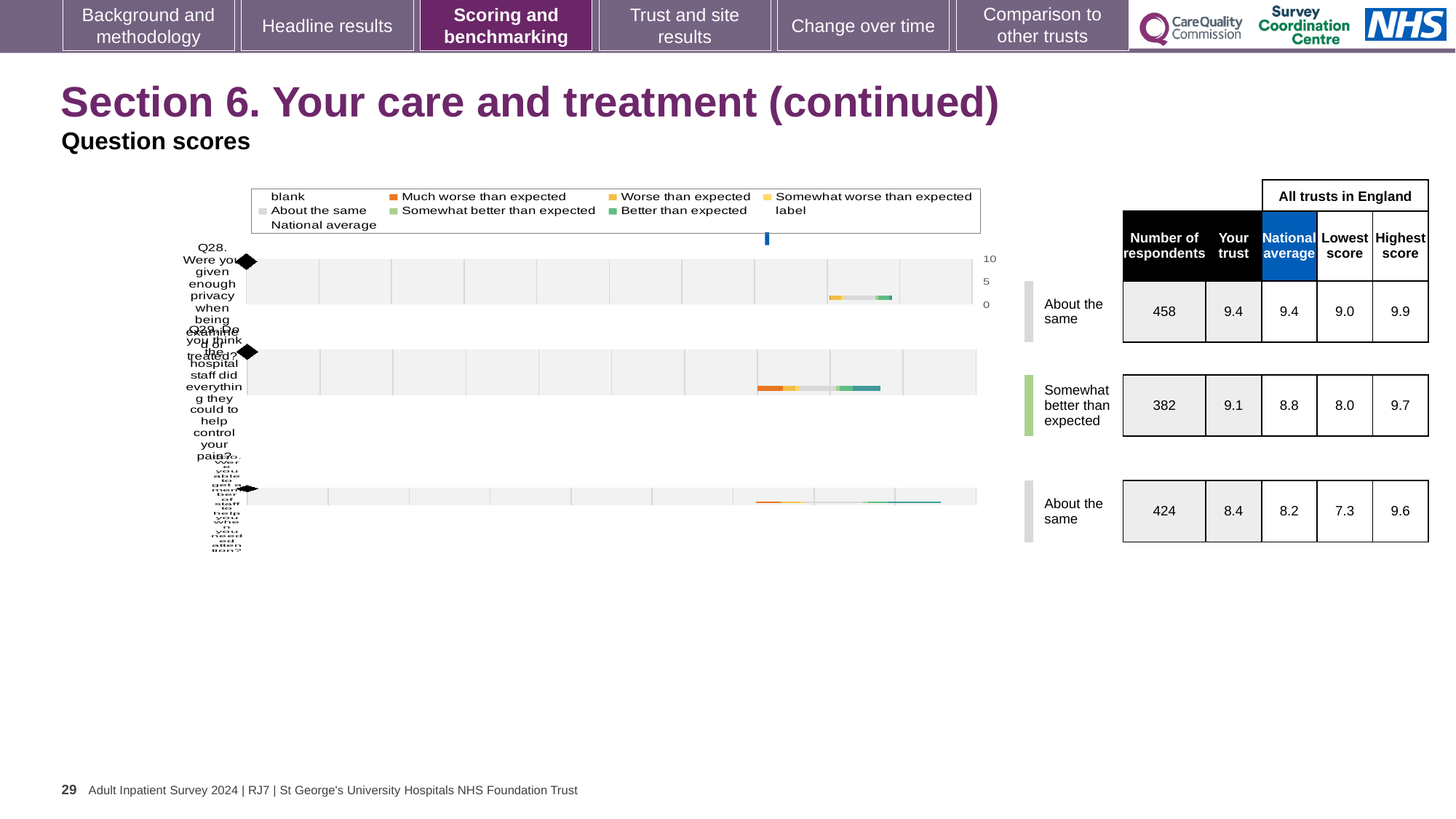
How many respondents answered the third question shown (Q30)? 424 How many questions are plotted on the chart? 3 What is the highest score across all trusts in England for Q28? 9.9 Which has the larger 'Your trust' score, Q28 or Q29? Q28 What is the 'Your trust' score for Q28 (privacy when being examined or treated)? 9.4 Which question has the highest 'Your trust' score? Q28 What is the national average score for Q29 (hospital staff did everything to help control your pain)? 8.8 Which question has the lowest 'Lowest score' across all trusts in England? Q30 What kind of chart is shown on the slide? Bar chart By how much does the trust's score for Q29 exceed the national average? 0.3 What is the difference between the highest score and the lowest score for Q30? 2.3 What benchmark category is shown for Q29? Somewhat better than expected